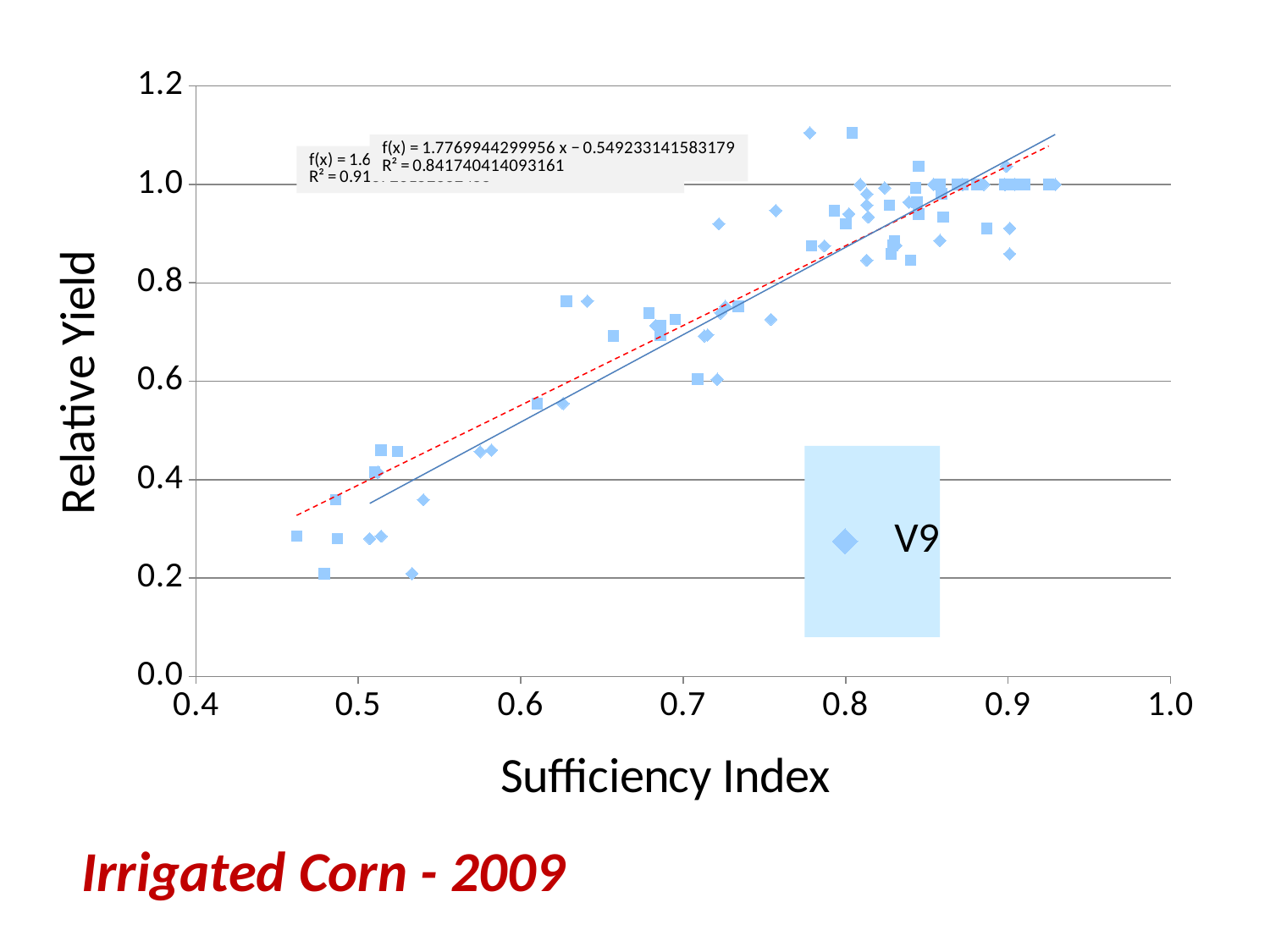
What is the slope printed in the fully readable trendline equation on the chart? 1.7769944299956 What is the title of the x axis of the chart? Sufficiency Index Do the Relative Yield values generally rise or fall as the Sufficiency Index increases? Rise Is the R² value of 0.841740414093161 printed on the chart greater or less than 0.8? greater How many series does the legend of the chart list? 1 What kind of chart is shown on the slide? Scatter chart What R² value is printed for the trendline equation f(x) = 1.7769944299956 x − 0.549233141583179? 0.841740414093161 What is the lowest value shown on the x axis of the chart? 0.4 What is the highest value shown on the y axis of the chart? 1.2